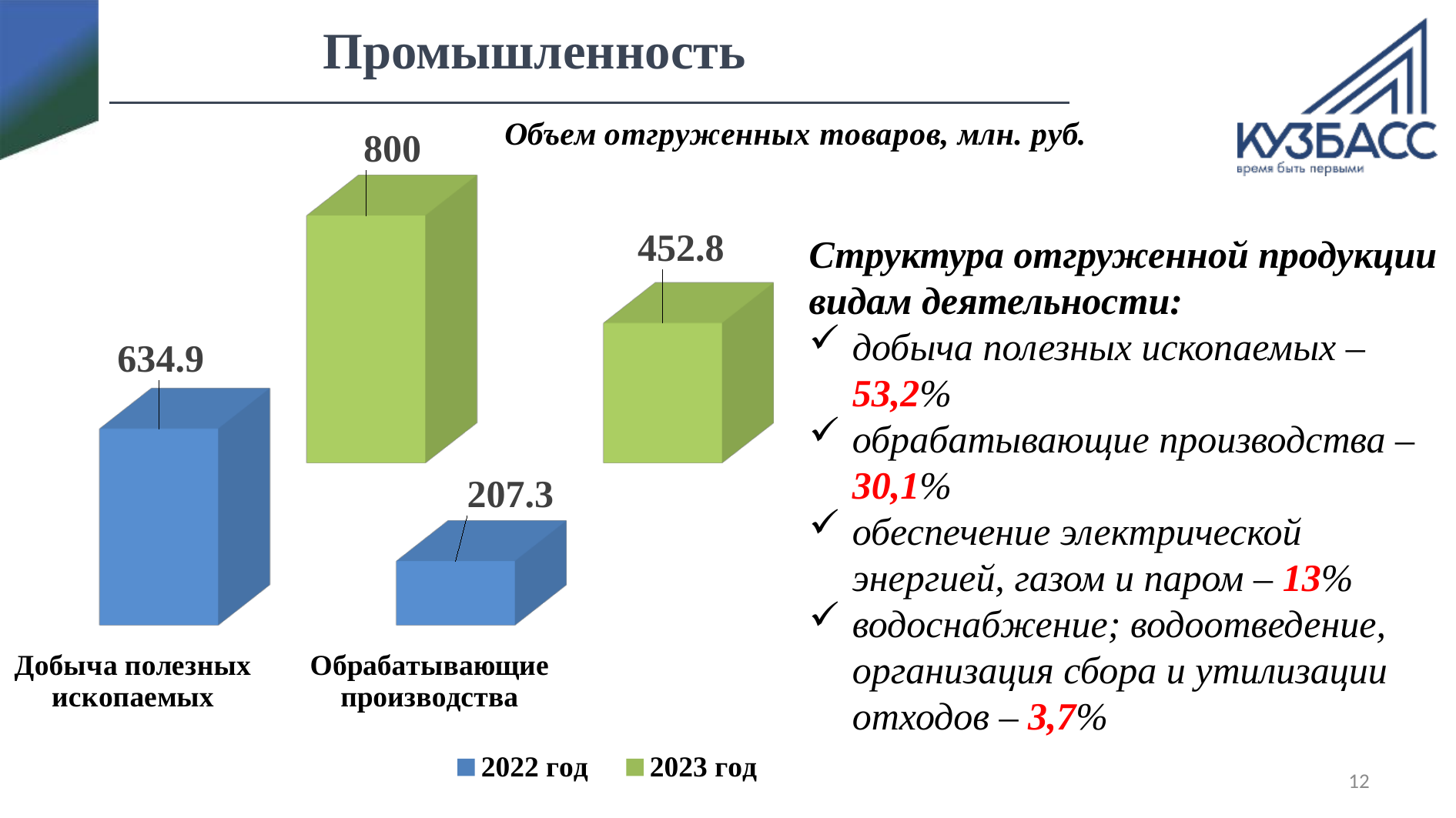
Which bar has the lowest value on the chart? Обрабатывающие производства, 2022 год Which is larger: the 2022 год value for Добыча полезных ископаемых or the 2023 год value for Обрабатывающие производства? 2022 год value for Добыча полезных ископаемых How many series does the chart legend list? 2 How many categories are shown on the x axis of the chart? 2 What is the value for Обрабатывающие производства in 2022 год? 207.3 What is the value for Добыча полезных ископаемых in 2022 год? 634.9 What is the value for Добыча полезных ископаемых in 2023 год? 800 What is the difference between the 2023 год and 2022 год values for Обрабатывающие производства? 245.5 What type of chart is shown on the slide? Bar chart Which bar has the highest value on the chart? Добыча полезных ископаемых, 2023 год What is the difference between the 2023 год and 2022 год values for Добыча полезных ископаемых? 165.1 What is the value for Обрабатывающие производства in 2023 год? 452.8